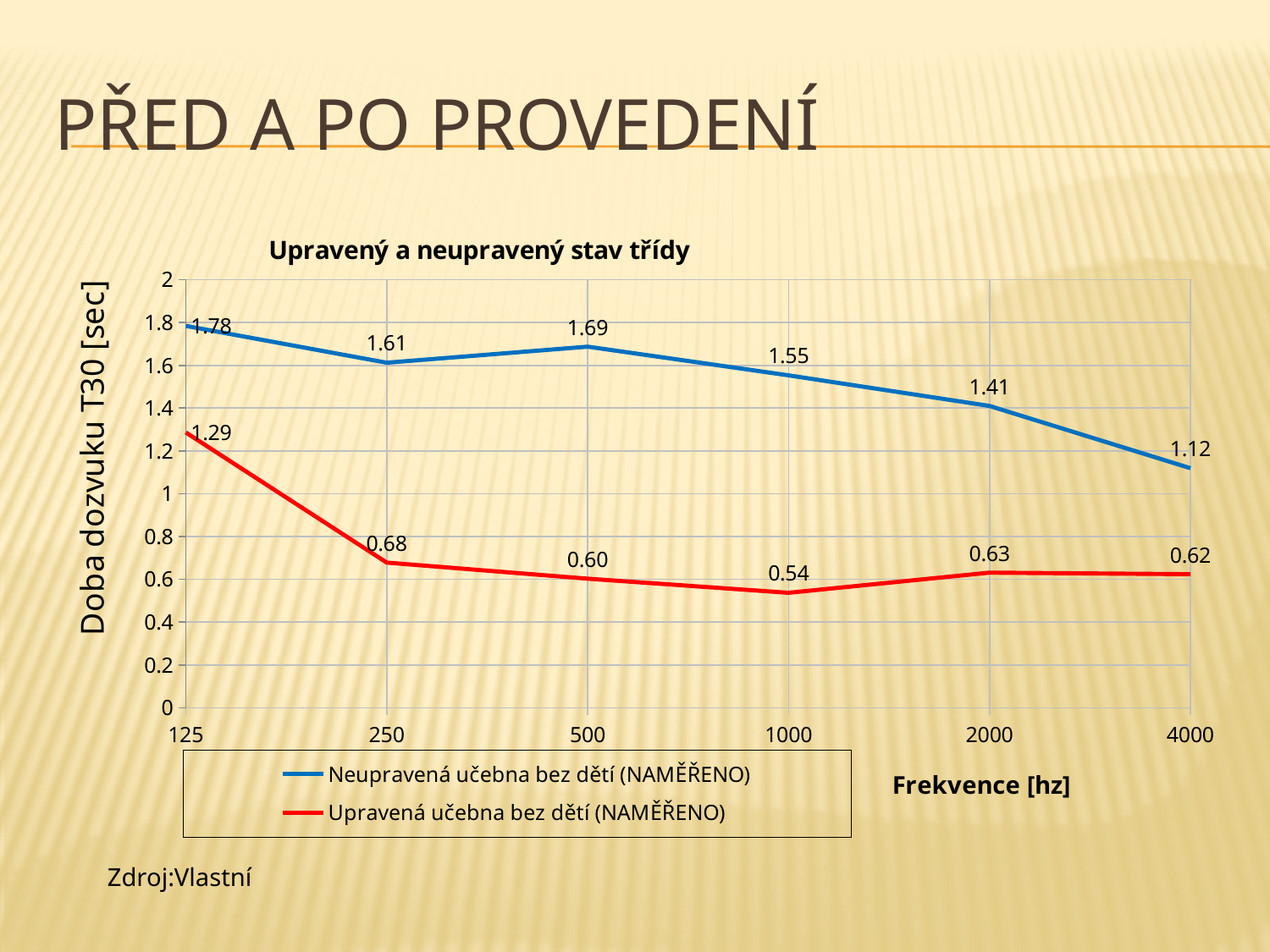
How many series does the legend list? 2 At which frequency is the value for Upravená učebna bez dětí (NAMĚŘENO) lowest? 1000 Does the value for Neupravená učebna bez dětí (NAMĚŘENO) rise or fall from 1000 Hz to 4000 Hz? fall What is the value for Upravená učebna bez dětí (NAMĚŘENO) at 1000 Hz? 0.54 At which frequency is the value for Neupravená učebna bez dětí (NAMĚŘENO) highest? 125 What type of chart is shown on the slide? line chart What is the value for Neupravená učebna bez dětí (NAMĚŘENO) at 4000 Hz? 1.12 How many frequency points are plotted on the x axis? 6 Which series has the larger value at 2000 Hz? Neupravená učebna bez dětí (NAMĚŘENO) What is the title of the chart? Upravený a neupravený stav třídy What is the value for Neupravená učebna bez dětí (NAMĚŘENO) at 125 Hz? 1.78 What is the difference between the two series at 250 Hz? 0.93